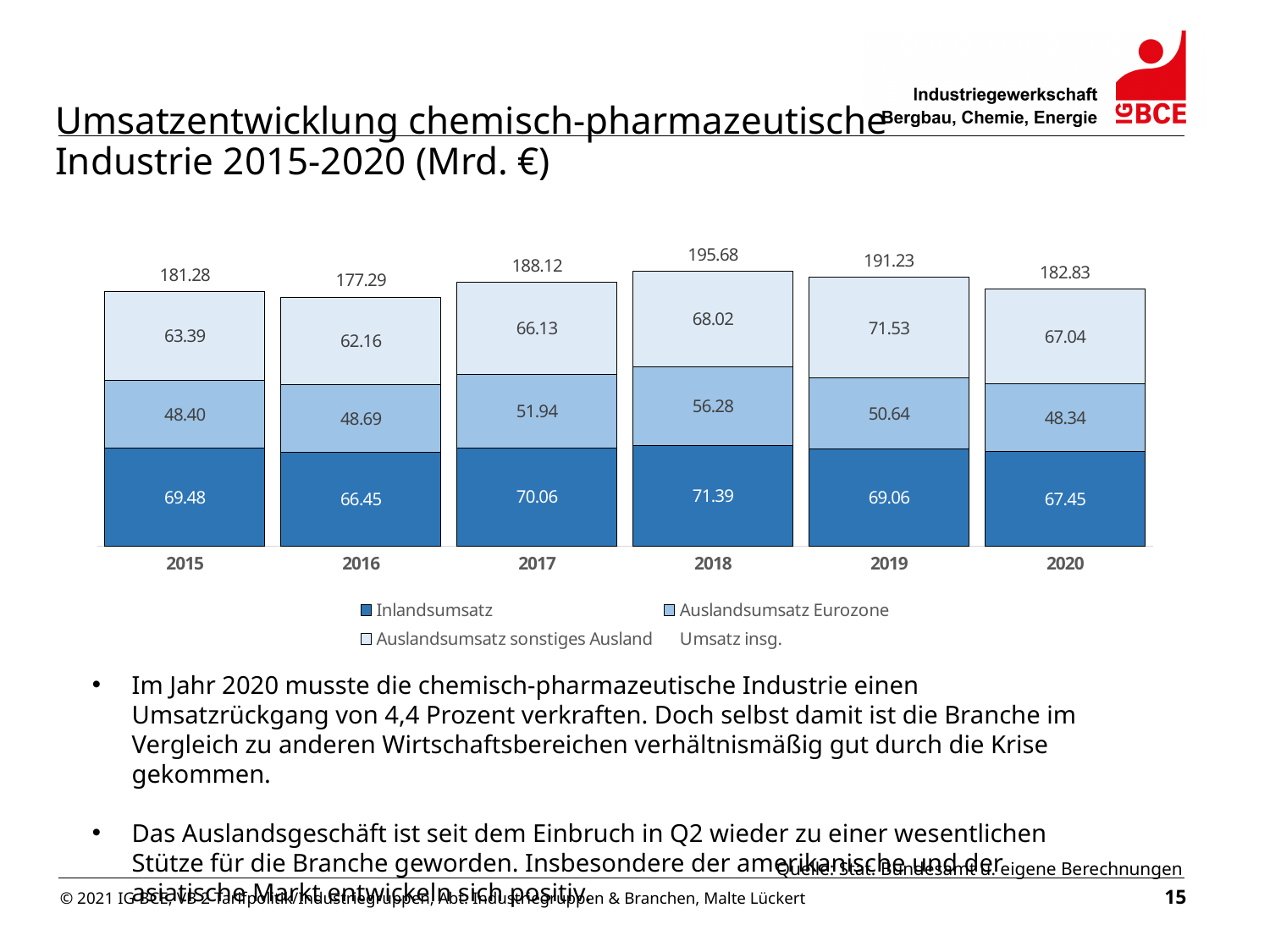
What is the total Umsatz insg. shown for 2020? 182.83 Which series is shown in the darkest blue at the bottom of each bar? Inlandsumsatz Which is larger, the Inlandsumsatz in 2017 or in 2016? 2017 Which year has the lowest total Umsatz insg.? 2016 Which year has the highest total Umsatz insg.? 2018 How many years are shown on the x axis? 6 What is the Auslandsumsatz sonstiges Ausland value for 2019? 71.53 What is the Inlandsumsatz value for 2018? 71.39 What kind of chart is shown on the slide? Stacked bar chart What is the difference between the total Umsatz insg. in 2019 and 2020? 8.40 How many entries does the legend list? 4 What is the Auslandsumsatz Eurozone value for 2017? 51.94